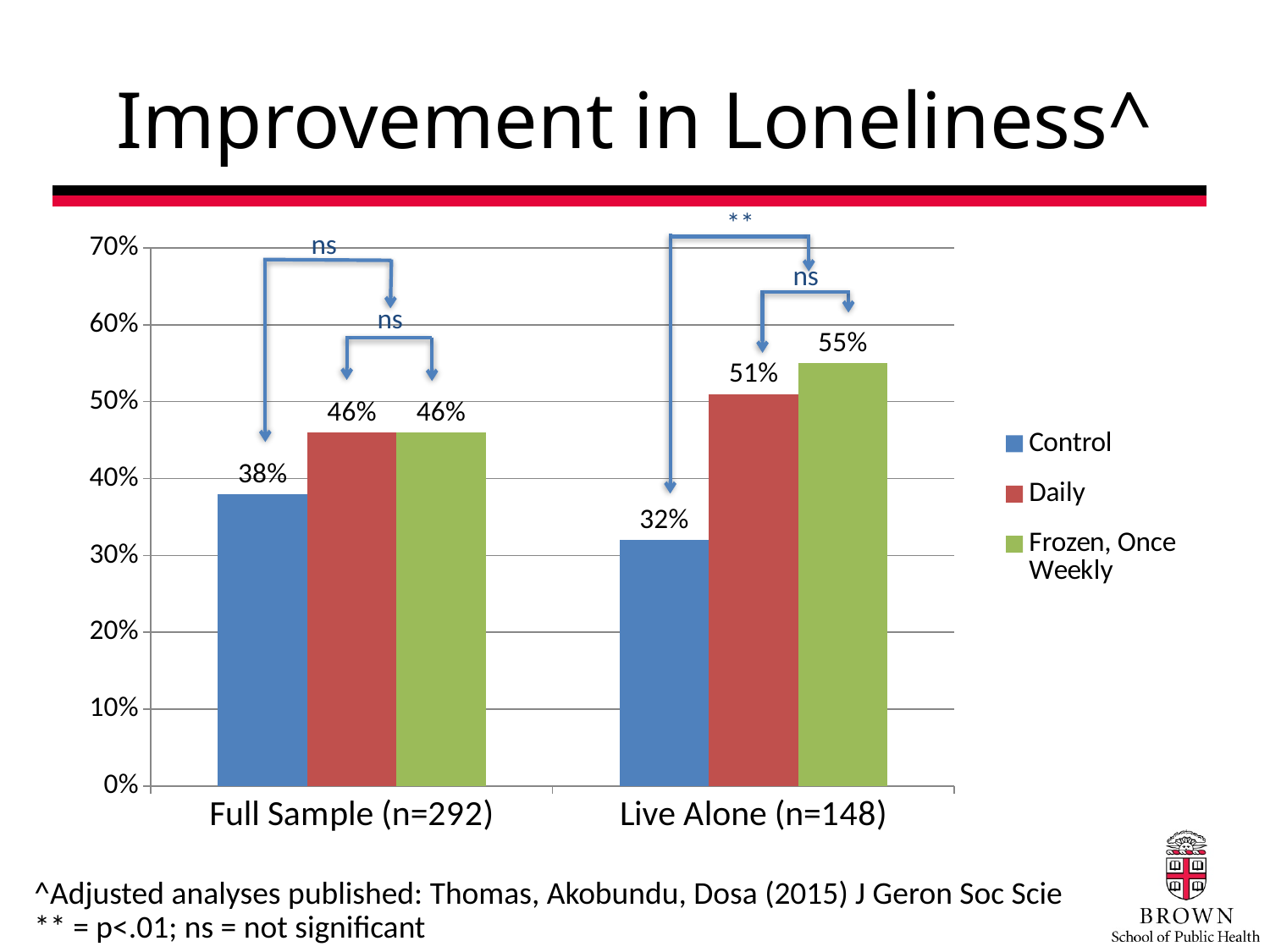
What is the value for Control in the Full Sample (n=292) group? 38% What is the title of the chart? Improvement in Loneliness^ Which series has the lowest value in the Full Sample (n=292) group? Control What is the value for Daily in the Live Alone (n=148) group? 51% Which series has the highest value in the Live Alone (n=148) group? Frozen, Once Weekly How many series does the legend list? 3 What is the difference between the Frozen, Once Weekly and Control values in the Live Alone (n=148) group? 23% How many category groups are shown on the x axis? 2 Which is larger: the Control value for Full Sample (n=292) or the Control value for Live Alone (n=148)? Full Sample (n=292) What is the value for Frozen, Once Weekly in the Live Alone (n=148) group? 55% What is the value for Control in the Live Alone (n=148) group? 32% What kind of chart is shown on the slide? Bar chart